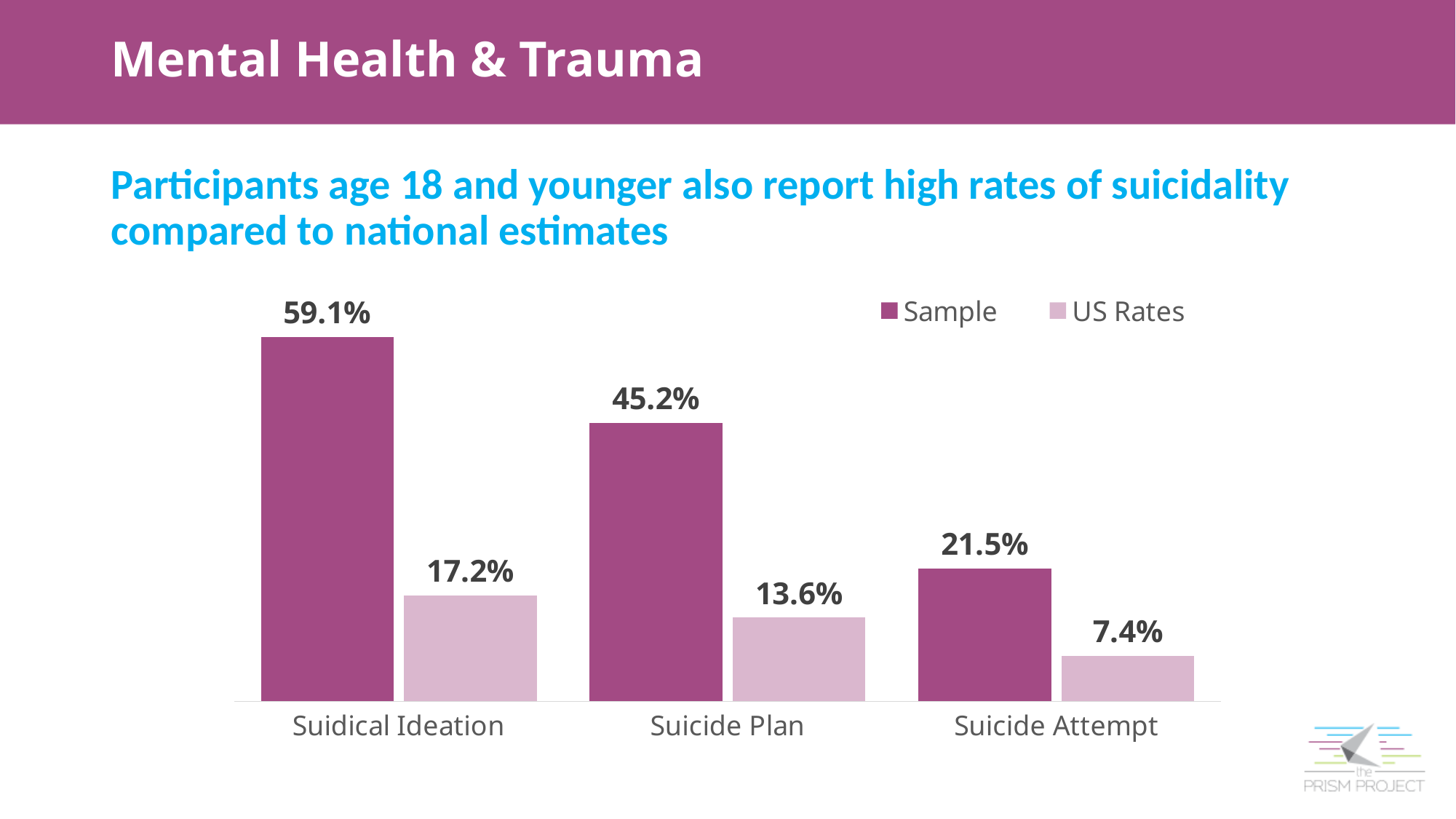
What kind of chart is shown on the slide? Bar chart Which category has the lowest US Rates value? Suicide Attempt How many categories are shown on the x axis? 3 Which category has the highest Sample value? Suidical Ideation What is the US Rates value for Suicide Plan? 13.6% What is the Sample value for Suicidal Ideation? 59.1% What is the Sample value for Suicide Plan? 45.2% What is the US Rates value for Suicide Attempt? 7.4% Which is larger: the Sample value for Suicide Attempt or the US Rates value for Suicidal Ideation? Sample value for Suicide Attempt What is the difference between the Sample and US Rates values for Suicide Attempt? 14.1% How many series does the legend list? 2 What is the difference between the Sample and US Rates values for Suicidal Ideation? 41.9%